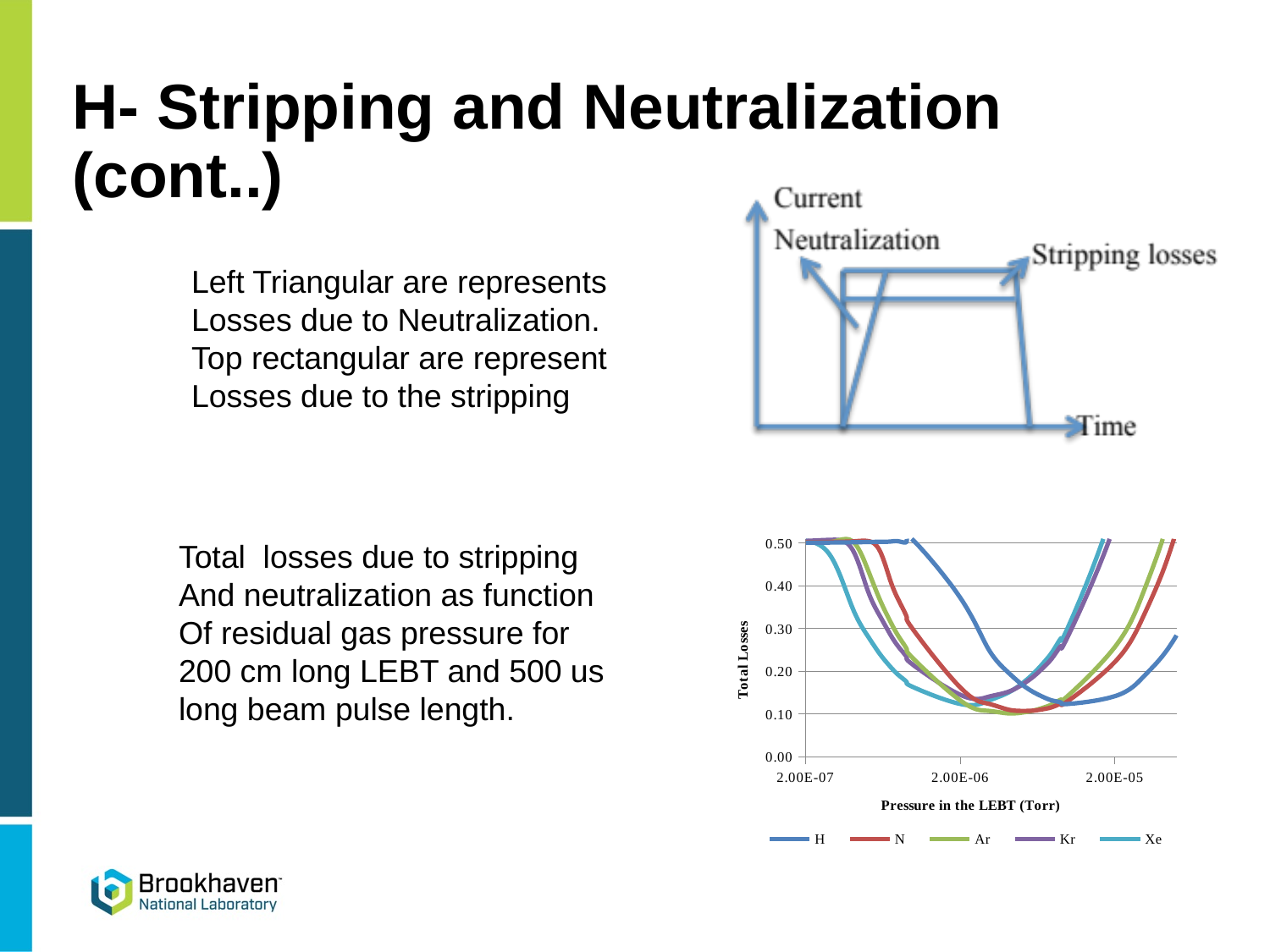
What kind of chart is the bottom-right chart with the x axis 'Pressure in the LEBT (Torr)'? line chart In the bottom-right line chart, what is the title of the y axis? Total Losses In the bottom-right line chart, is the value for H at 2.00E-06 greater or less than 0.20? greater In the bottom-right line chart, does the H series rise or fall as pressure increases from 2.00E-07 to 2.00E-06? fall In the bottom-right line chart, at a pressure of 2.00E-06, which series has the larger value, H or Xe? H In the bottom-right line chart, which series reaches its minimum at the highest pressure? H In the bottom-right line chart, is the value for Xe at 2.00E-06 greater or less than 0.20? less How many series does the legend of the bottom-right line chart list? 5 In the bottom-right line chart, how many labelled tick values are shown on the x axis? 3 In the bottom-right line chart, does the Xe series rise or fall as pressure increases from 2.00E-06 to 2.00E-05? rise In the bottom-right line chart, is the value for H at 2.00E-07 greater or less than 0.40? greater In the bottom-right line chart, what are the series names listed in the legend? H, N, Ar, Kr, Xe